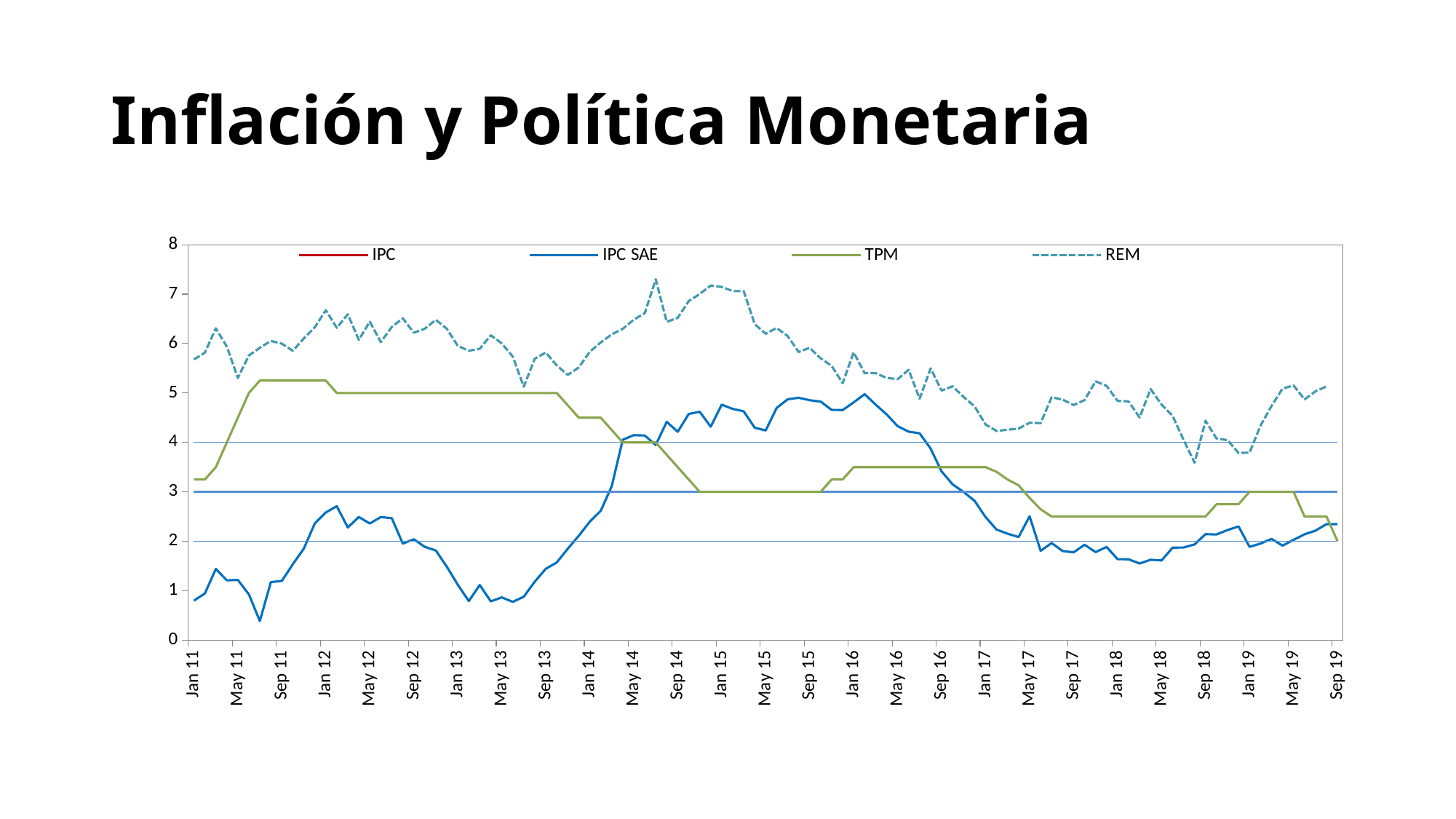
Which series in the legend is drawn with a dashed line? REM Is the value of IPC SAE at Jan 11 greater or less than 1? less Is the value of TPM at Jan 12 greater or less than 5? greater How many series does the chart legend list? 4 What kind of chart is shown on the slide? line chart Is the value of REM at Sep 18 greater or less than 4? greater Does the IPC SAE series rise or fall between Jan 17 and Jan 18? fall Does the TPM series rise or fall between Jan 11 and Sep 11? rise At Jan 12, which series has the larger value, TPM or IPC SAE? TPM What is the title of the slide? Inflación y Política Monetaria